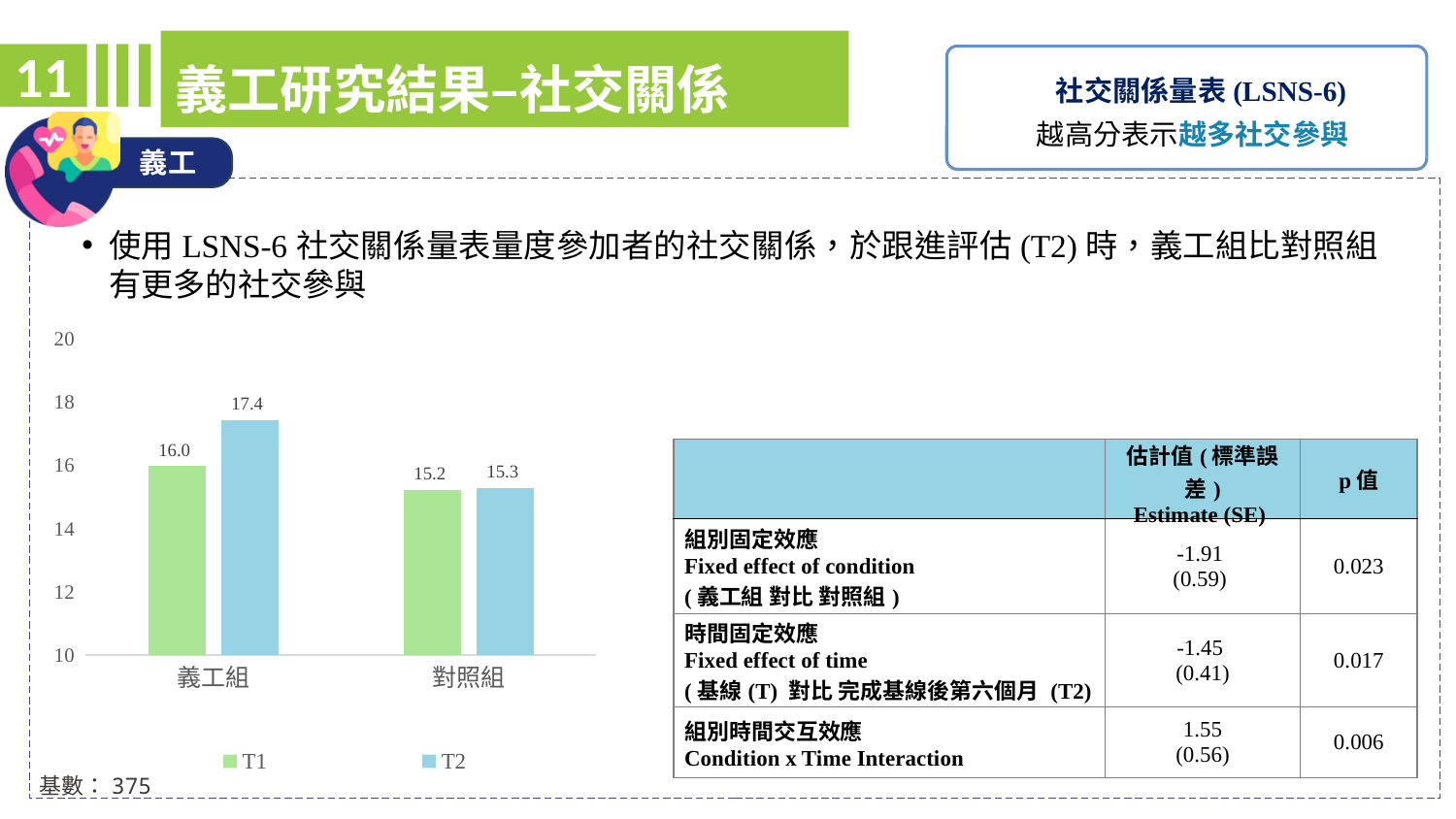
Which group has the highest T2 value? 義工組 What is the difference between the T2 values of 義工組 and 對照組? 2.1 What is the difference between the T2 and T1 values for 義工組? 1.4 Which group has the lowest T1 value? 對照組 What is the T1 value for 義工組? 16.0 What is the T2 value for 對照組? 15.3 Which is larger: the T1 value for 義工組 or the T1 value for 對照組? 義工組 What is the T1 value for 對照組? 15.2 What is the T2 value for 義工組? 17.4 How many series does the chart legend list? 2 How many groups (categories) are shown on the x axis of the chart? 2 What kind of chart is shown on the slide? bar chart